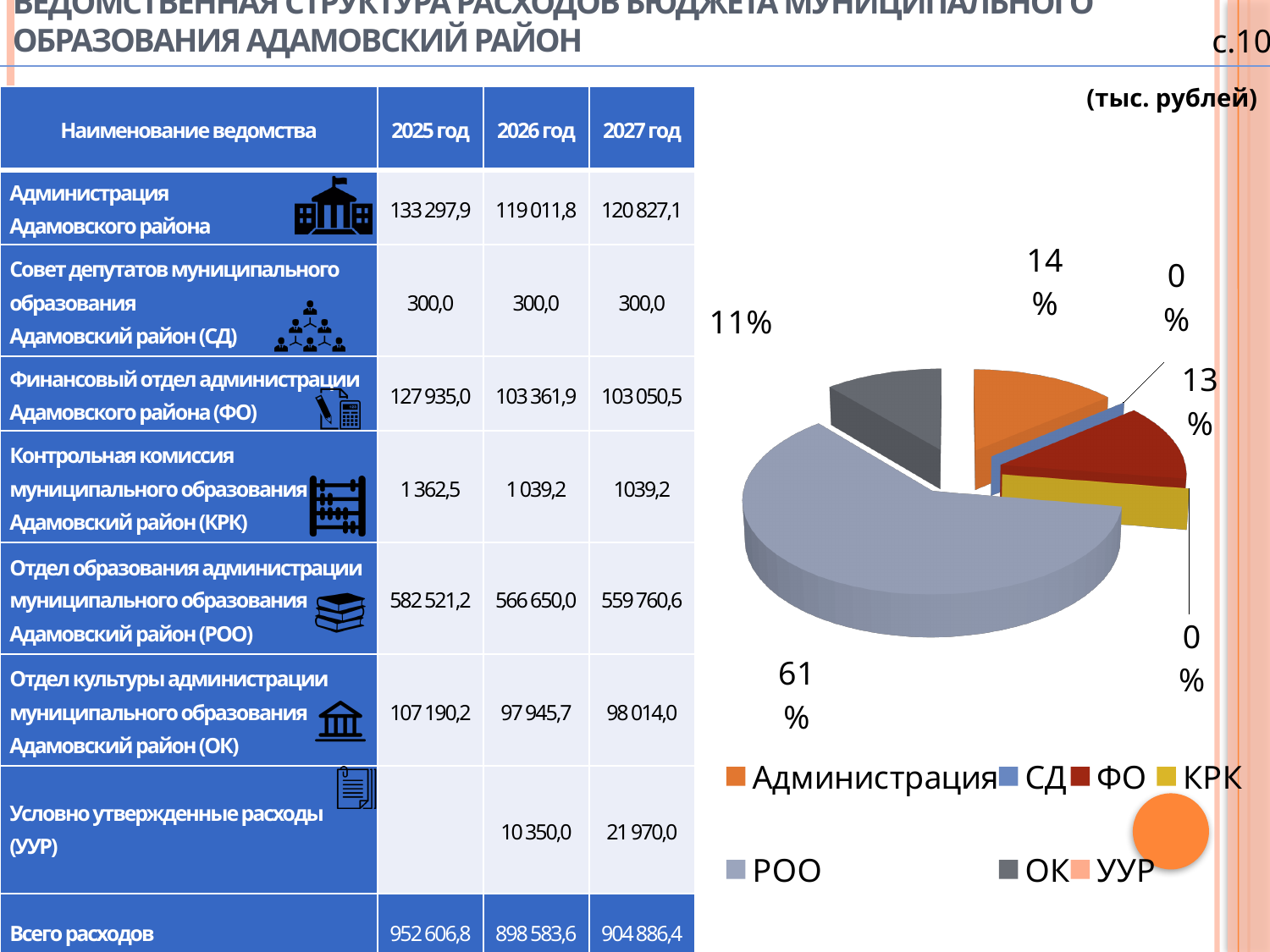
In the pie chart, what share is shown for Администрация? 14% In the pie chart, what colour is the slice for РОО? grey-blue In the pie chart, what share is shown for ФО? 13% How many entries does the legend of the pie chart list? 7 In the pie chart, which department has the largest share? РОО In the pie chart, how many percentage points larger is the share for РОО than the share for Администрация? 47 In the pie chart, what colour is the slice for Администрация? orange In the pie chart, what share is shown for ОК? 11% In the pie chart, what share is shown for КРК? 0% In the pie chart, what share is shown for РОО? 61% What kind of chart is shown on the right side of the slide? pie chart In the pie chart, which is larger, the share for Администрация or the share for ОК? Администрация